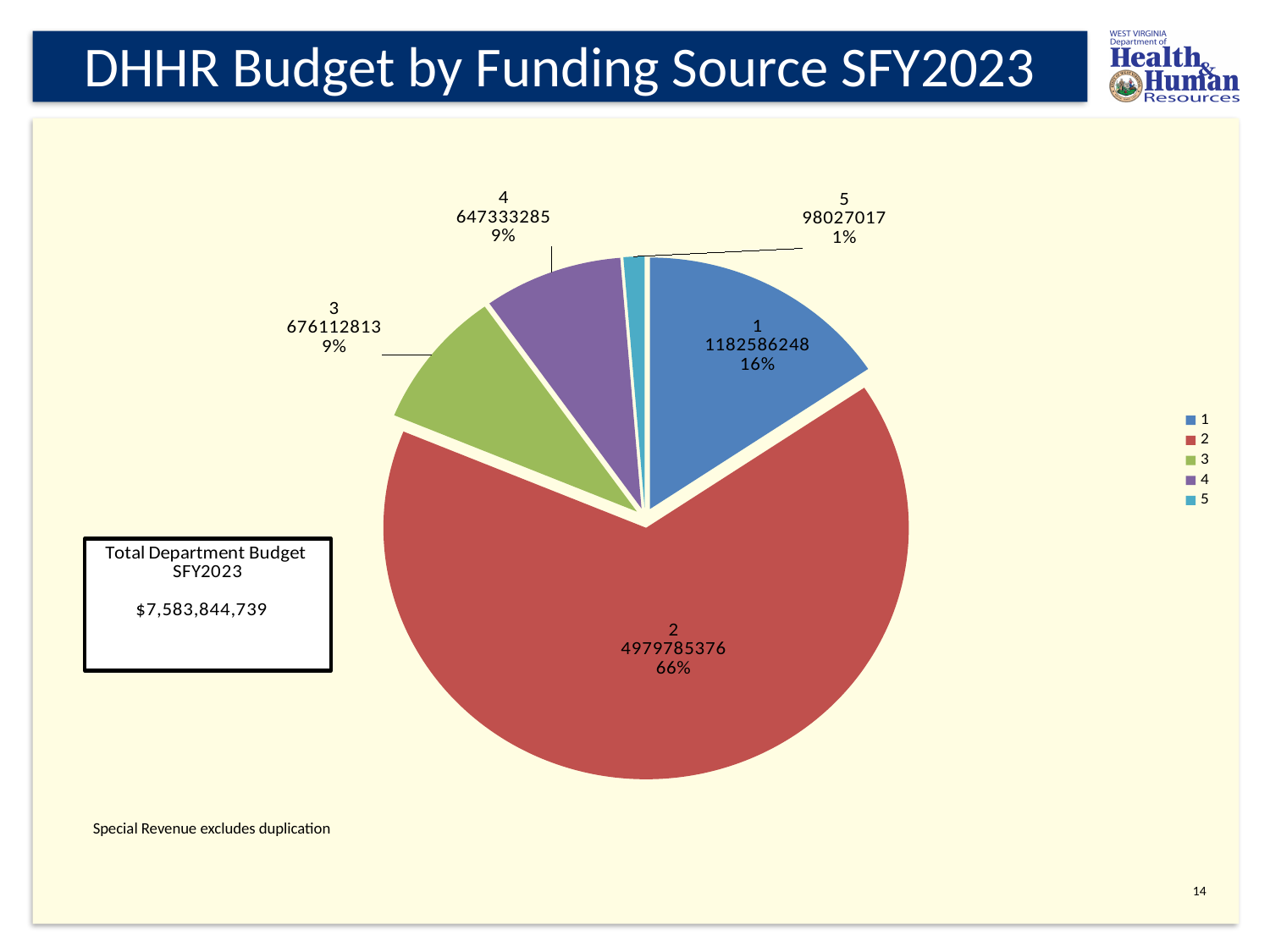
How many slices does the pie chart have? 5 How many entries does the legend list? 5 Which category has the largest slice of the pie? 2 Which has the larger value, category 3 or category 4? 3 What is the value shown for category 2 in the pie chart? 4979785376 Which category has the smallest slice of the pie? 5 What is the value shown for category 5? 98027017 What type of chart is shown on the slide? pie chart What is the title of the slide containing the pie chart? DHHR Budget by Funding Source SFY2023 What is the difference between the values for category 2 and category 1? 3797199128 What percentage share does category 4 have? 9% What percentage share does category 1 have in the pie chart? 16%